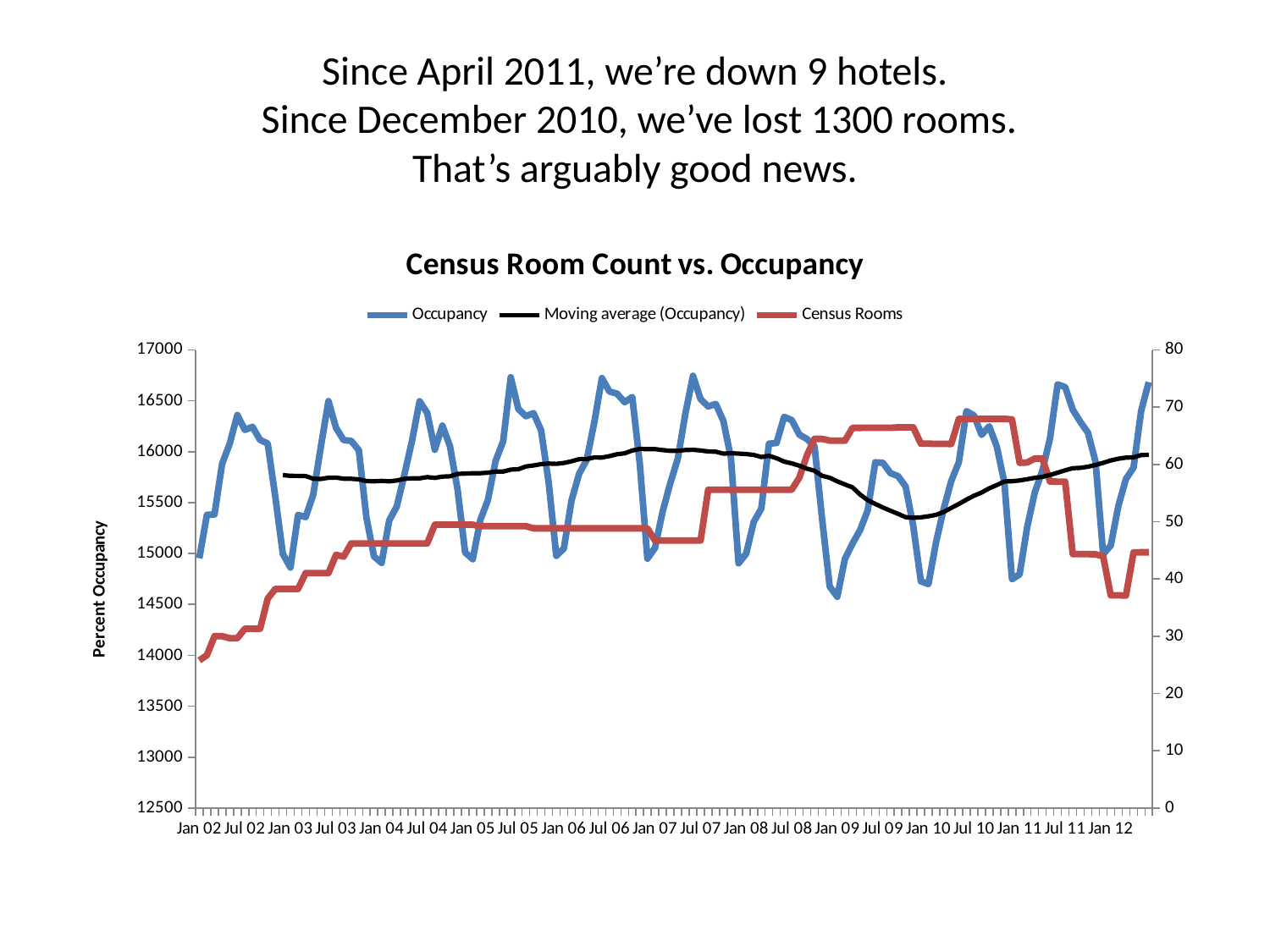
What is the title of the chart? Census Room Count vs. Occupancy Is the Census Rooms value at Jan 10 greater or less than 16000 on the left axis? greater Is the Census Rooms value at Jan 02 greater or less than 14500 on the left axis? less What kind of chart is shown on the slide? line chart Is the Census Rooms value higher at Jan 10 or at Jan 02? Jan 10 Which series is drawn in red in the chart? Census Rooms Is the Census Rooms value at Jan 12 greater or less than 15500 on the left axis? less How many series does the chart's legend list? 3 What is the highest value shown on the right-hand axis of the chart? 80 Does the Moving average (Occupancy) line rise or fall between Jan 09 and Jan 10? fall Does the Census Rooms line rise or fall between Jan 11 and Jan 12? fall Does the Census Rooms line rise or fall between Jan 02 and Jan 10? rise